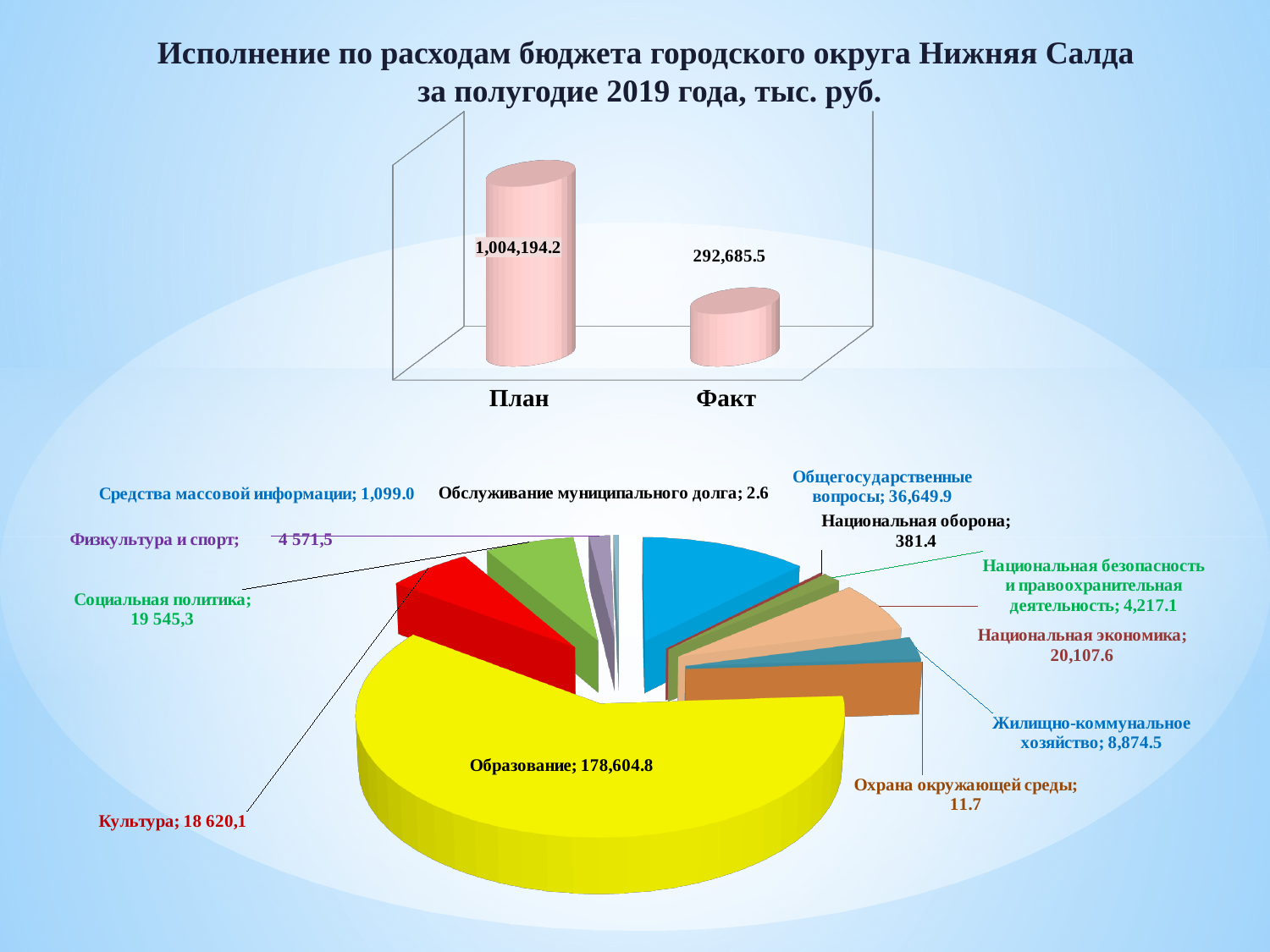
How many categories are shown in the bottom pie chart? 12 In the top bar chart, which is larger, План or Факт? План In the top bar chart, what is the value for План? 1,004,194.2 In the bottom pie chart, which category has the largest value? Образование In the bottom pie chart, what is the value for Национальная экономика? 20,107.6 In the bottom pie chart, what is the value for Обслуживание муниципального долга? 2.6 In the bottom pie chart, which category has the smallest value? Обслуживание муниципального долга In the bottom pie chart, what is the value for Образование? 178,604.8 What kind of chart is the top chart on the slide? Bar chart In the top bar chart, what is the difference between План and Факт? 711,508.7 In the top bar chart, what is the value for Факт? 292,685.5 In the bottom pie chart, which is larger, Социальная политика or Культура? Социальная политика